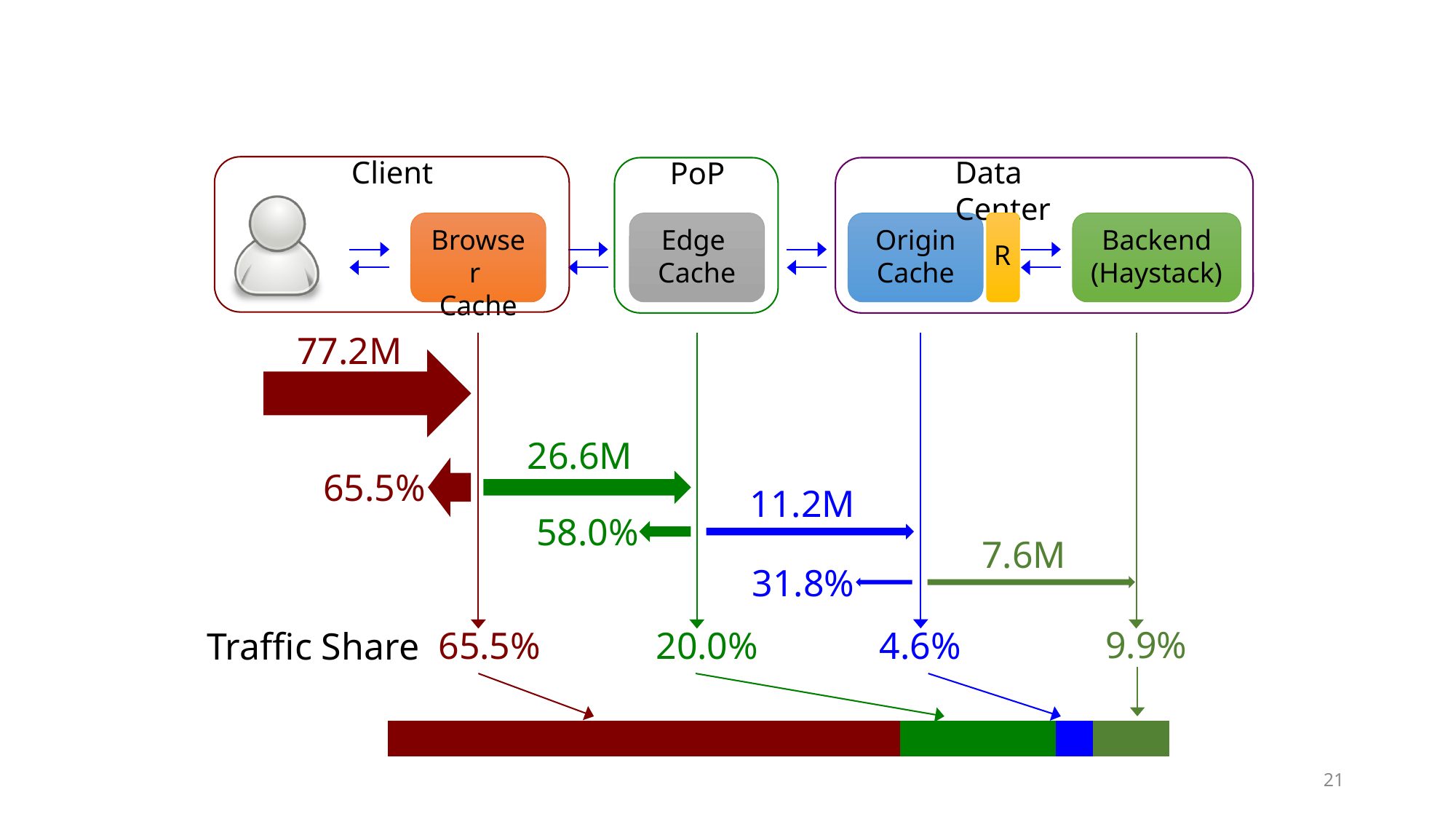
How many segments make up the Traffic Share bar? 4 Which segment of the Traffic Share bar has the smallest share? Origin Cache What is the traffic share for the Origin Cache segment of the Traffic Share bar? 4.6% Which segment of the Traffic Share bar has the largest share? Browser Cache Which has a larger traffic share, Backend (Haystack) or Origin Cache? Backend (Haystack) What is the total of the four traffic share segments in the Traffic Share bar? 100.0% What kind of chart is the Traffic Share graphic at the bottom of the slide? Stacked bar chart What colour is the Origin Cache segment of the Traffic Share bar? Blue What is the traffic share for the Backend (Haystack) segment of the Traffic Share bar? 9.9% What is the traffic share for the Browser Cache segment of the Traffic Share bar? 65.5% What is the traffic share for the Edge Cache segment of the Traffic Share bar? 20.0% What is the difference between the Browser Cache traffic share and the Edge Cache traffic share? 45.5%